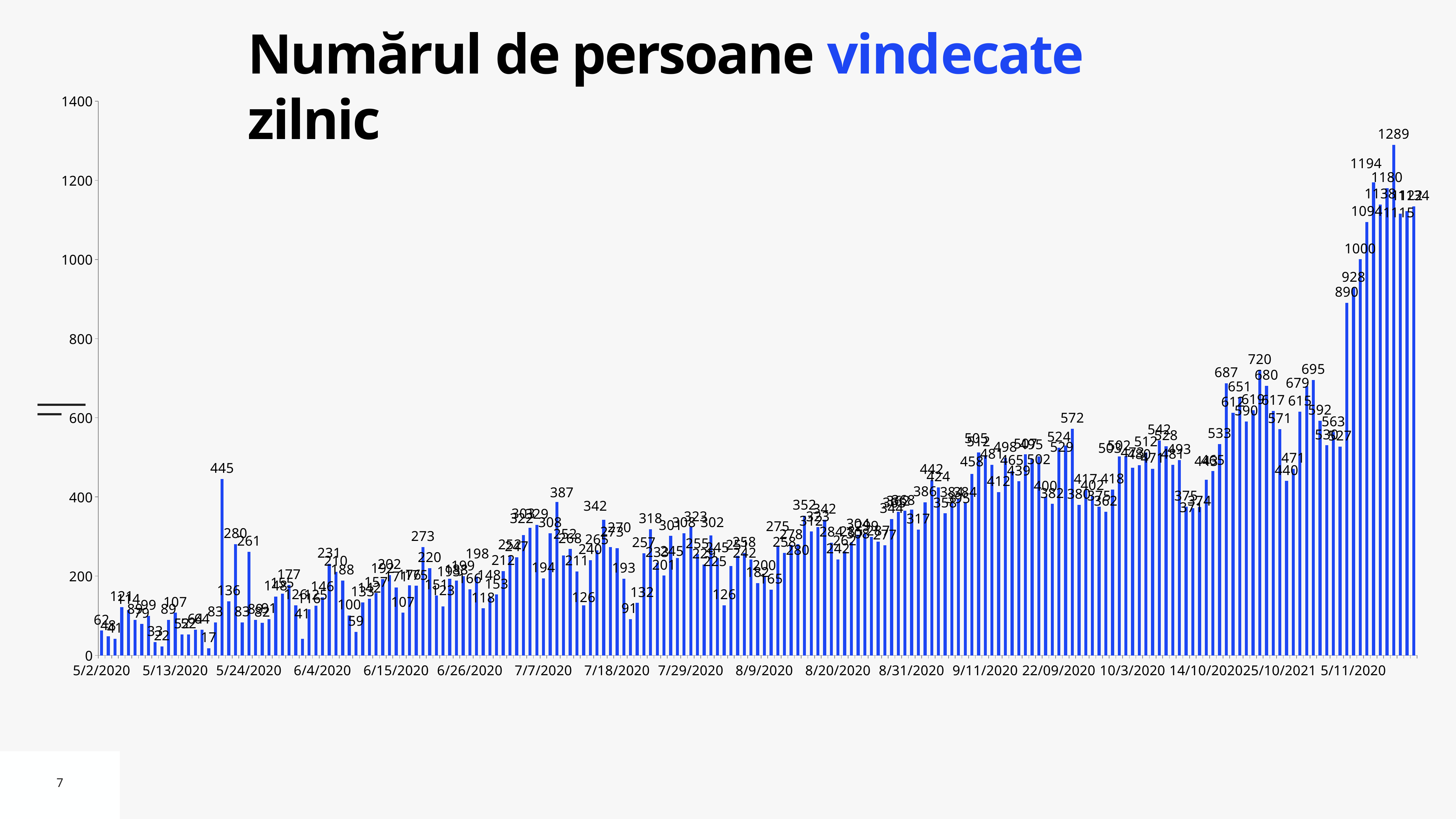
Do the values generally rise or fall from left to right along the x axis? rise What is the value of the tall spike between 5/13/2020 and 5/24/2020? 445 What type of chart is shown on the slide? bar chart What is the value of the first bar, at 5/2/2020? 62 Is the tallest bar in the chart greater or less than 1200? greater What is the title of the chart? Numărul de persoane vindecate zilnic What is the highest daily value shown in the chart? 1289 What is the lowest daily value shown in the chart? 17 Which is larger: the spike of 445 in May or the peak of 387 in early July? 445 What is the difference between the bar labelled 1289 and the bar labelled 1194? 95 Is the value for 5/2/2020 greater or less than 200? less What is the difference between the highest value (1289) and the lowest value (17) in the chart? 1272